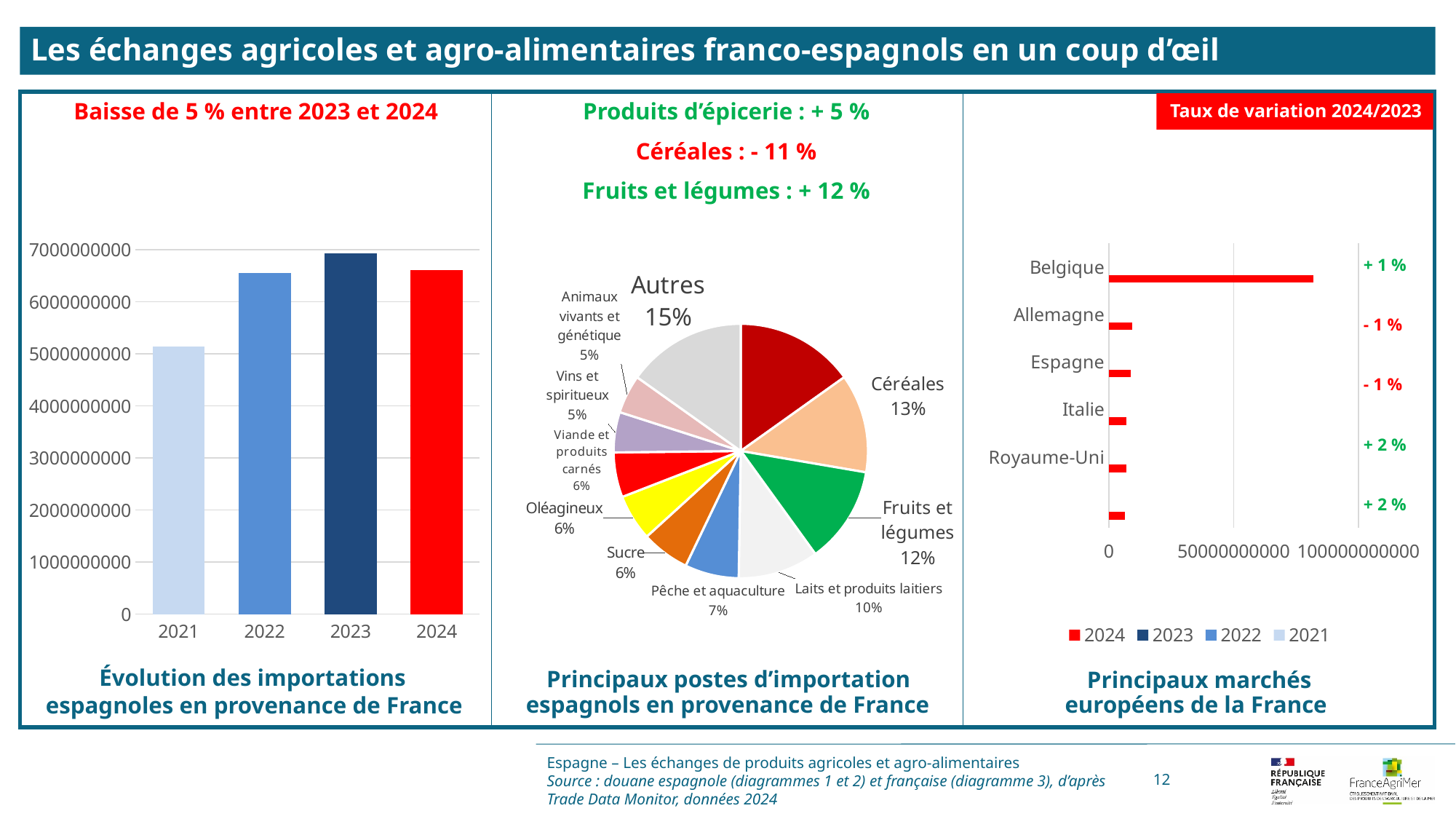
In the right chart 'Principaux marchés européens de la France', is the value for Belgique greater or less than 50000000000? greater What kind of chart is the left chart, 'Évolution des importations espagnoles en provenance de France'? bar chart How many series does the legend of the right chart 'Principaux marchés européens de la France' list? 4 In the left chart 'Évolution des importations espagnoles en provenance de France', which is larger, the value for 2021 or the value for 2022? 2022 In the left chart 'Évolution des importations espagnoles en provenance de France', which year has the highest value? 2023 In the right chart 'Principaux marchés européens de la France', which country has the highest value? Belgique In the left chart 'Évolution des importations espagnoles en provenance de France', which year has the lowest value? 2021 In the middle pie chart 'Principaux postes d'importation espagnols en provenance de France', what share does Céréales have? 13% In the left chart 'Évolution des importations espagnoles en provenance de France', how many years are plotted? 4 In the middle pie chart 'Principaux postes d'importation espagnols en provenance de France', what share does Autres have? 15% In the left chart 'Évolution des importations espagnoles en provenance de France', is the value for 2021 greater or less than 6000000000? less In the middle pie chart 'Principaux postes d'importation espagnols en provenance de France', what share does Laits et produits laitiers have? 10%